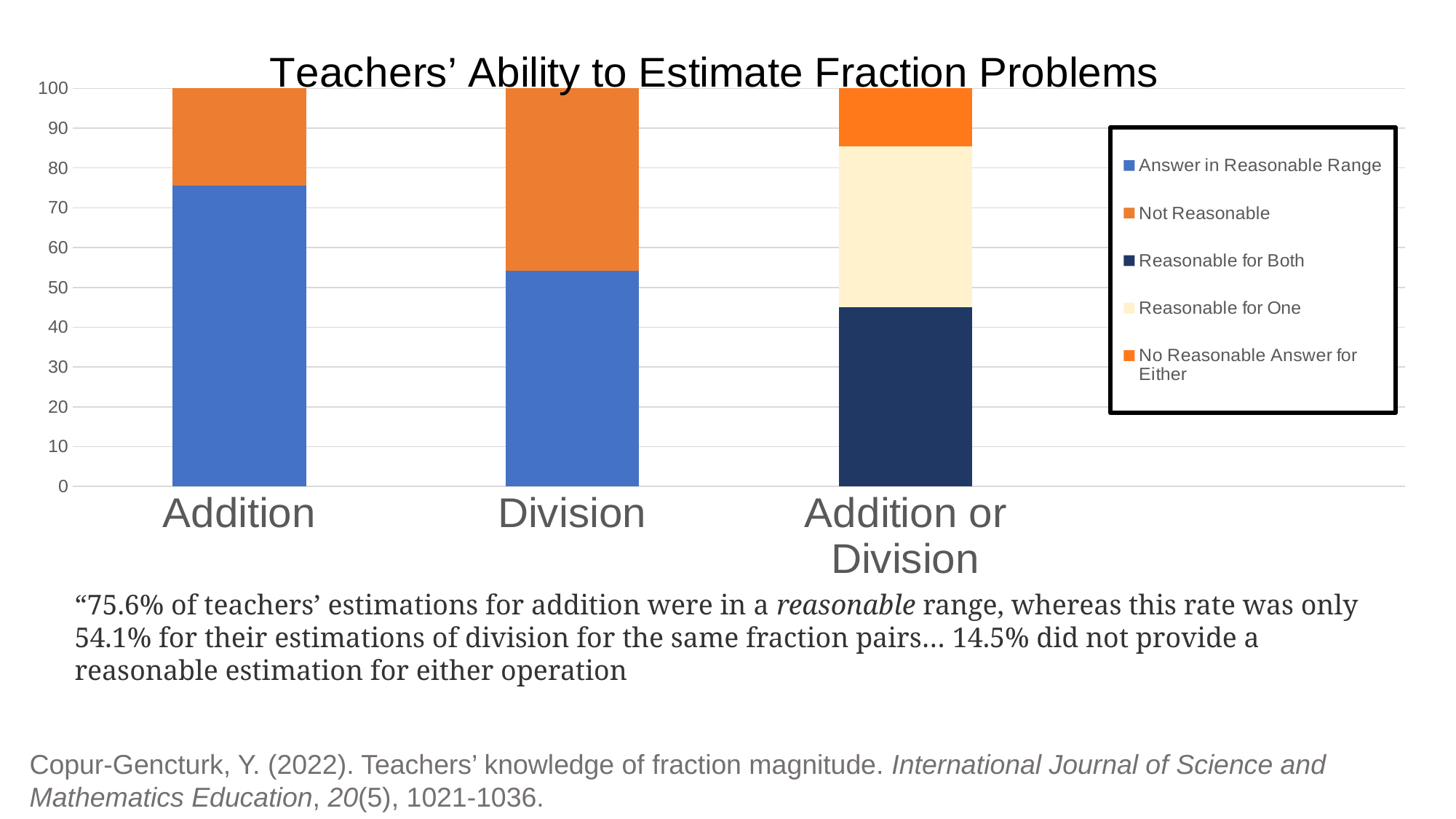
Is the 'Reasonable for Both' value for Addition or Division greater or less than 50? less Which category has the larger 'Not Reasonable' value, Addition or Division? Division How many categories are shown on the x axis of the chart? 3 What kind of chart is shown on the slide? Stacked bar chart Is the 'Not Reasonable' value for Division greater or less than 40? greater Which category has the larger 'Answer in Reasonable Range' value, Addition or Division? Addition How many series does the chart's legend list? 5 What is the title of the chart? Teachers' Ability to Estimate Fraction Problems Is the 'Answer in Reasonable Range' value for Addition greater or less than 70? greater What is the total height of the stacked bar for Addition? 100 Which legend entry is shown in the light cream colour? Reasonable for One